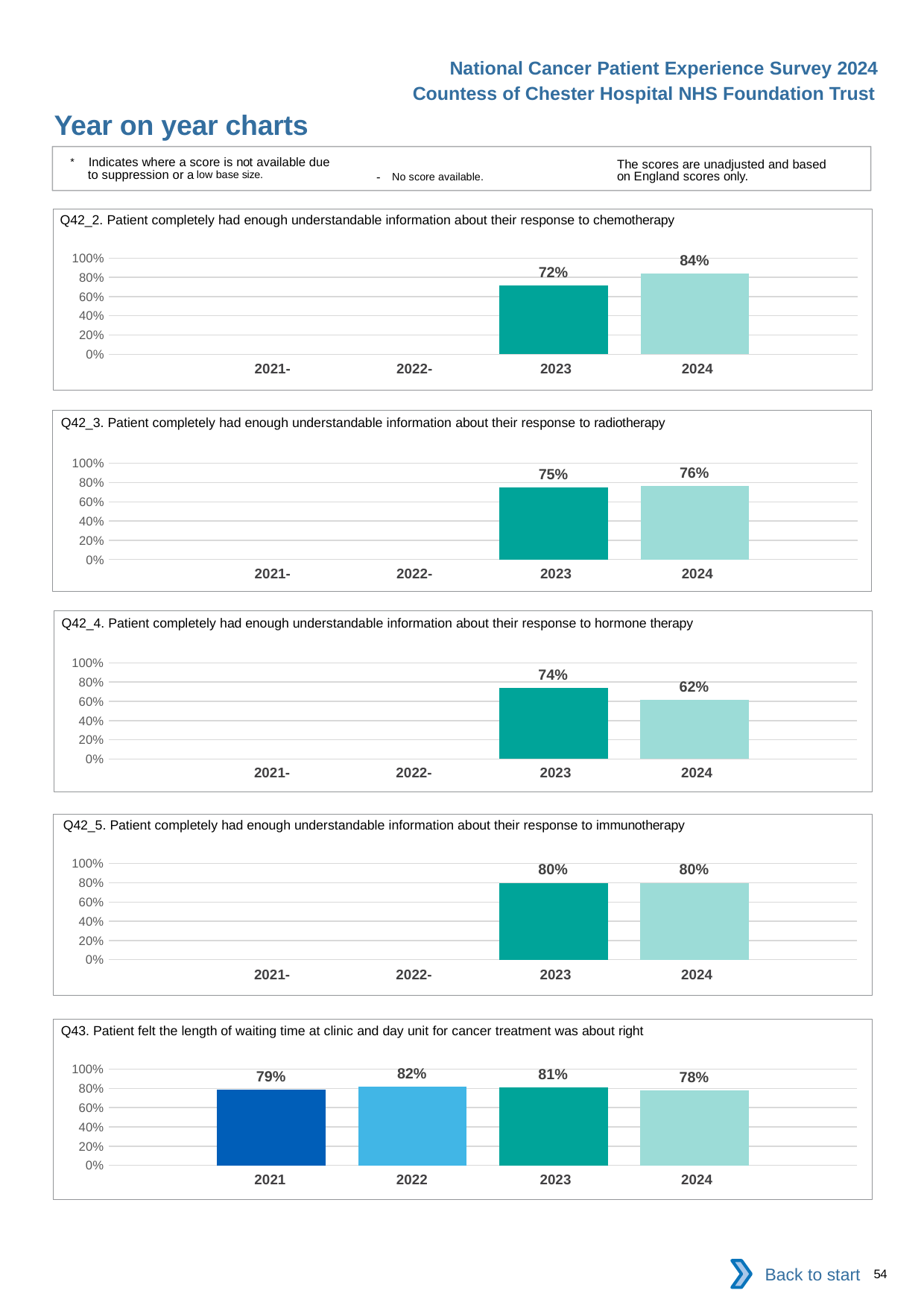
In the Q42_2 chart (information about response to chemotherapy), what is the difference between the 2024 and 2023 values? 12% In the Q42_2 chart (information about response to chemotherapy), what is the value for 2024? 84% In the Q42_3 chart (information about response to radiotherapy), what is the value for 2023? 75% In the Q43 chart (waiting time at clinic and day unit), which year has the lowest value? 2024 In the Q43 chart (waiting time at clinic and day unit), what is the difference between the 2022 and 2024 values? 4% In the Q42_5 chart (information about response to immunotherapy), what is the value for 2023? 80% In the Q43 chart (waiting time at clinic and day unit), which year has the highest value? 2022 In the Q42_3 chart (information about response to radiotherapy), how many years have a bar plotted? 2 In the Q42_4 chart (information about response to hormone therapy), does the value rise or fall from 2023 to 2024? fall What kind of chart is the Q43 chart (waiting time at clinic and day unit)? bar chart In the Q42_4 chart (information about response to hormone therapy), which year has the higher value, 2023 or 2024? 2023 In the Q42_4 chart (information about response to hormone therapy), what is the value for 2024? 62%